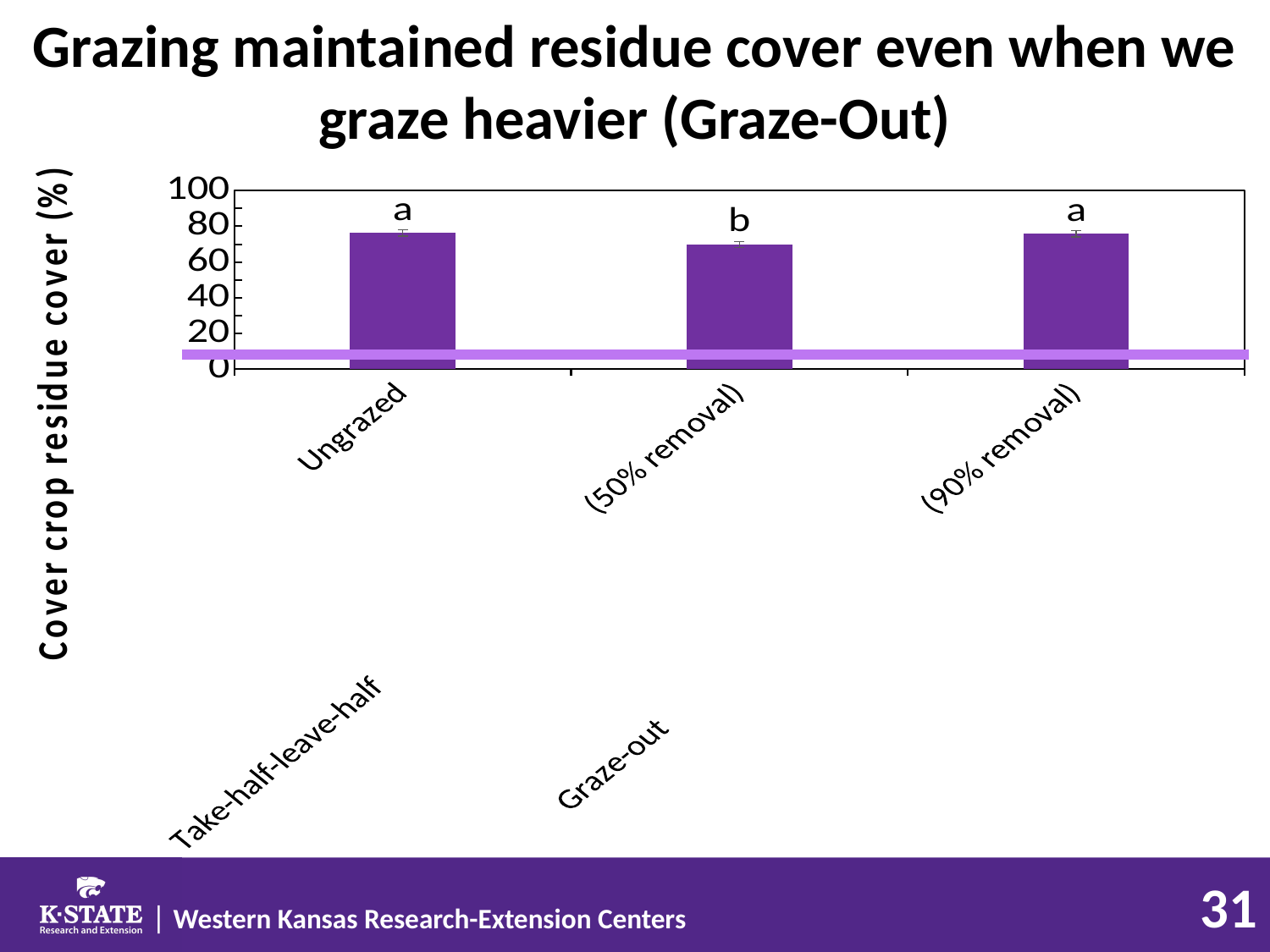
How many bars (categories) are plotted in the chart? 3 What letter is printed above the Take-half-leave-half (50% removal) bar? b Which category has the lowest cover crop residue cover? Take-half-leave-half (50% removal) Is the value for Graze-out (90% removal) greater or less than 60? greater Which has the larger cover crop residue cover, Graze-out (90% removal) or Take-half-leave-half (50% removal)? Graze-out (90% removal) Is the value for Take-half-leave-half (50% removal) greater or less than 80? less What is the label of the y axis? Cover crop residue cover (%) Is the value for Take-half-leave-half (50% removal) greater or less than 40? greater What kind of chart is shown on the slide? bar chart Which has the larger cover crop residue cover, Ungrazed or Take-half-leave-half (50% removal)? Ungrazed